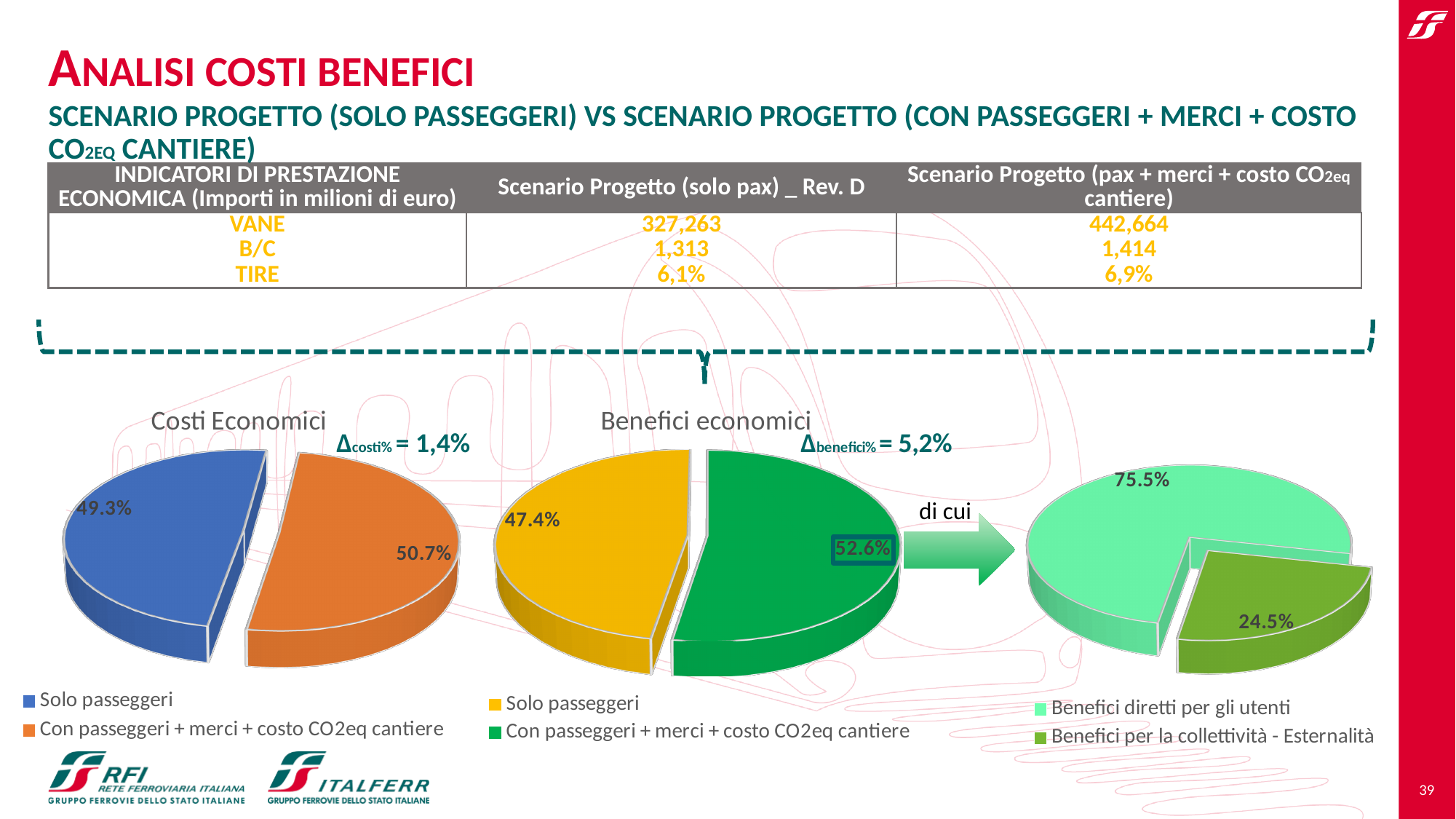
In the Costi Economici pie chart, what share is labelled for Solo passeggeri? 49.3% In the Benefici economici pie chart, what share is labelled for Solo passeggeri? 47.4% In the rightmost pie chart, what share is labelled for Benefici diretti per gli utenti? 75.5% In the Benefici economici pie chart, what share is labelled for Con passeggeri + merci + costo CO2eq cantiere? 52.6% In the rightmost pie chart, what share is labelled for Benefici per la collettività - Esternalità? 24.5% How many slices does the Costi Economici pie chart have? 2 In the Benefici economici pie chart, which is larger: Solo passeggeri or Con passeggeri + merci + costo CO2eq cantiere? Con passeggeri + merci + costo CO2eq cantiere What type of chart is used for Costi Economici? Pie chart In the Costi Economici pie chart, what share is labelled for Con passeggeri + merci + costo CO2eq cantiere? 50.7% In the Benefici economici pie chart, which slice is the smallest? Solo passeggeri In the rightmost pie chart, what is the difference between the two slices' percentages? 51.0% In the rightmost pie chart, which slice is the largest? Benefici diretti per gli utenti